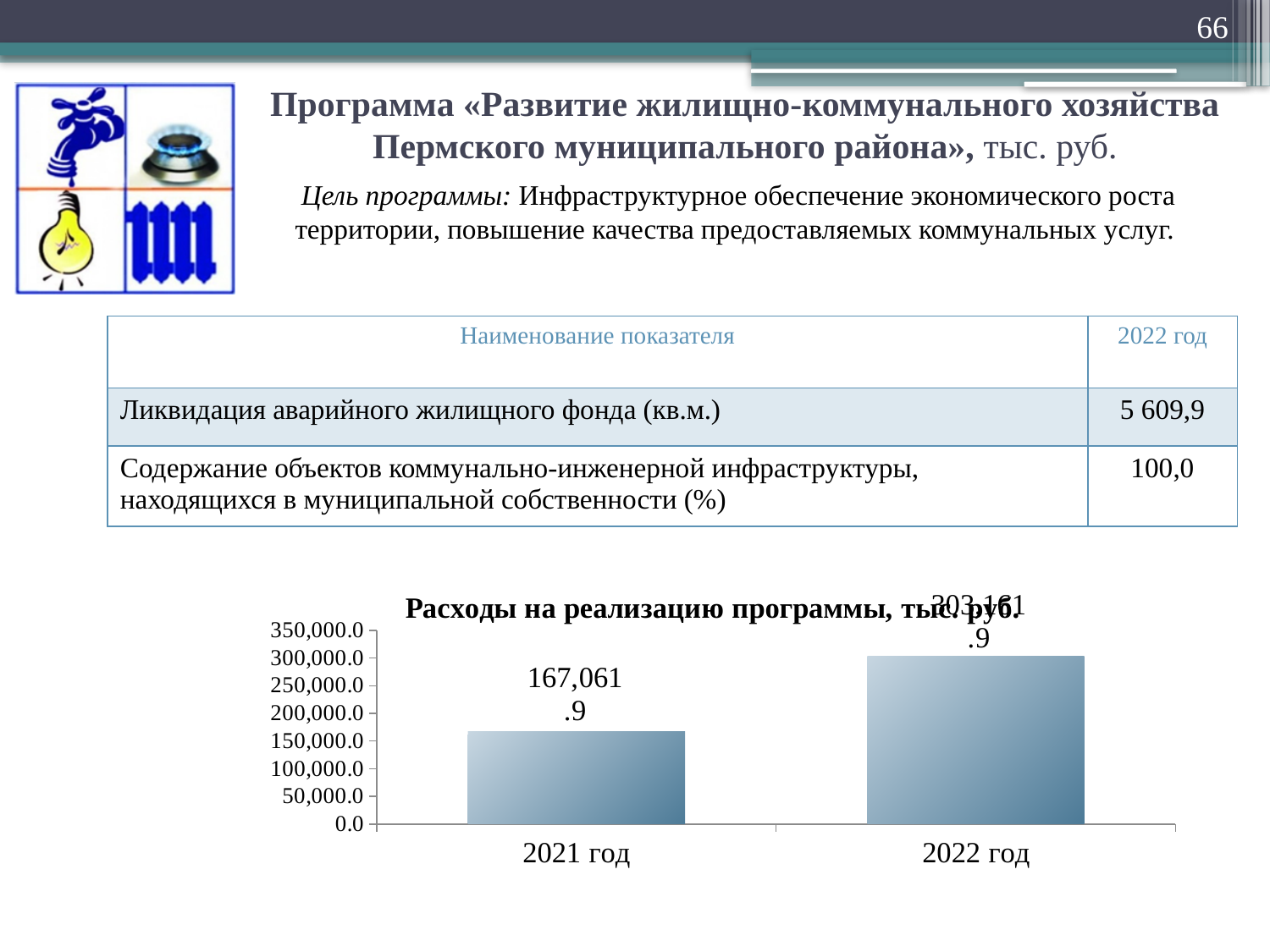
What kind of chart is shown on the slide? bar chart What is the difference between the values for 2022 год and 2021 год in the chart? 136,100.0 Which year has the highest value in the chart? 2022 год How many categories (years) are shown on the x axis of the chart? 2 Which is larger in the chart, the value for 2021 год or for 2022 год? 2022 год Is the value for 2022 год greater or less than 250,000.0? greater What is the title of the chart on the slide? Расходы на реализацию программы, тыс. руб. What is the value for 2022 год in the chart? 303,161.9 What is the value for 2021 год in the chart? 167,061.9 Do the values in the chart rise or fall from 2021 год to 2022 год? rise Is the value for 2021 год greater or less than 200,000.0? less Which year has the lowest value in the chart? 2021 год